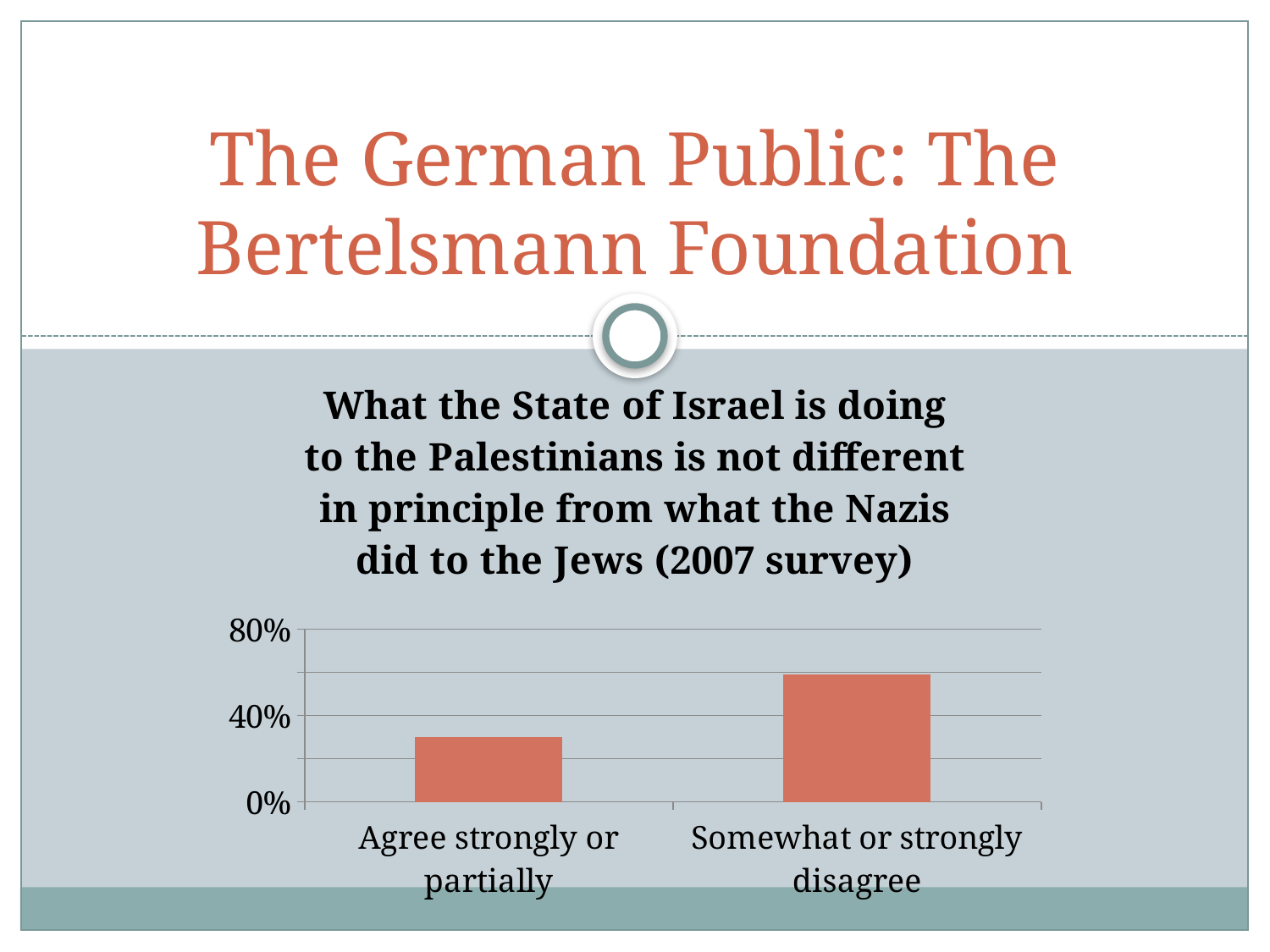
Is the value for "Somewhat or strongly disagree" greater or less than 80%? less Which category has the lowest bar? Agree strongly or partially What is the highest value shown on the y axis of the chart? 80% Do the bar values rise or fall from left to right along the x axis? Rise Is the value for "Agree strongly or partially" greater or less than 40%? less What kind of chart is shown on the slide? Bar chart How many categories are shown on the x axis of the chart? 2 Is the value for "Agree strongly or partially" greater or less than 20%? greater In what year was the survey shown in the chart conducted, according to the chart title? 2007 Which is larger: the value for "Agree strongly or partially" or the value for "Somewhat or strongly disagree"? Somewhat or strongly disagree Which category has the highest bar? Somewhat or strongly disagree